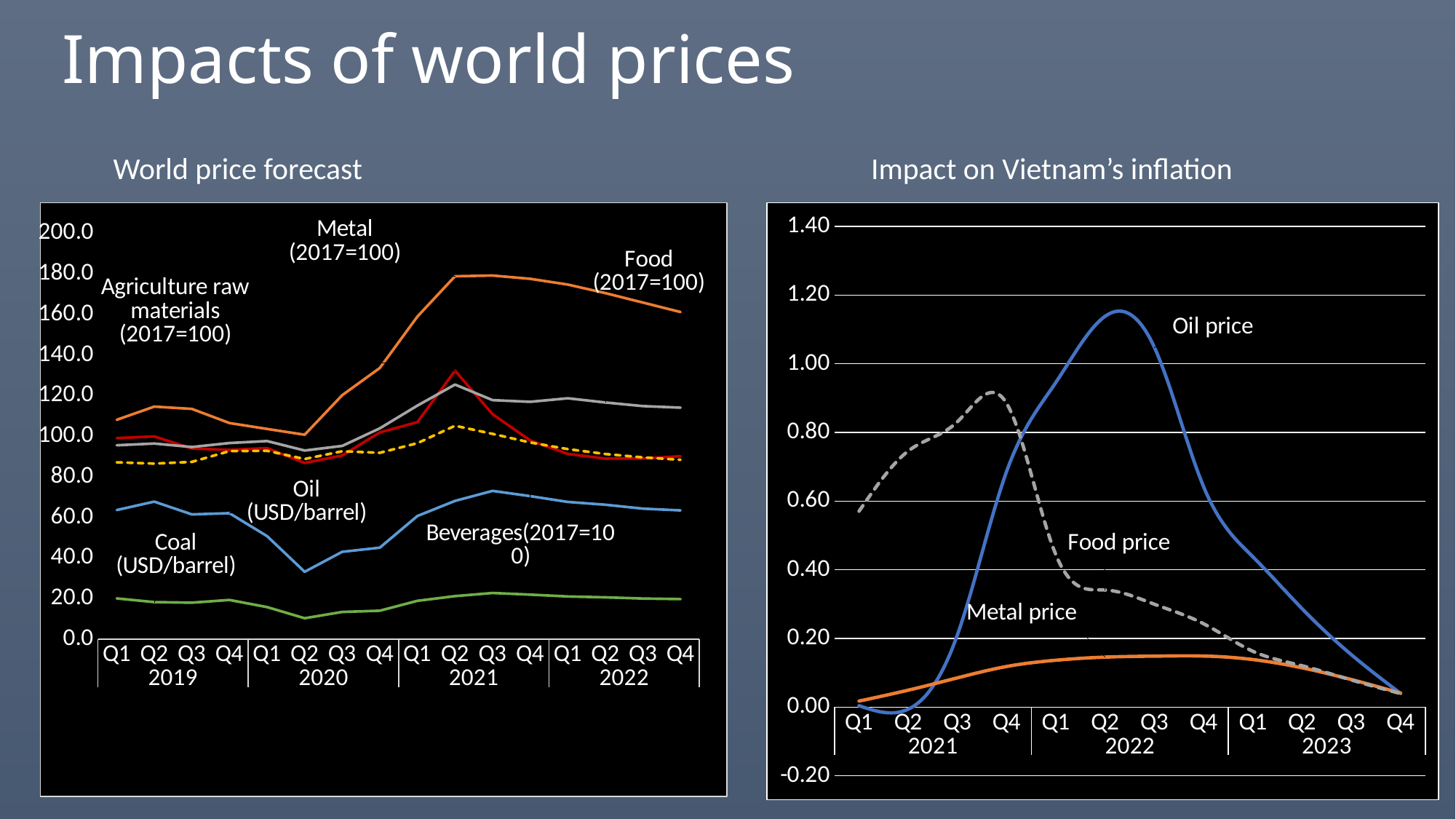
In the 'World price forecast' chart, how many series are plotted? 6 In the 'World price forecast' chart, is the value for Metal in Q2 2021 greater or less than 160.0? greater In the 'World price forecast' chart, does the Metal series rise or fall from Q3 2021 to Q4 2022? fall In the 'World price forecast' chart, how many quarterly points are shown on the x axis? 16 In the 'Impact on Vietnam's inflation' chart, which series reaches the highest peak? Oil price In the 'Impact on Vietnam's inflation' chart, is the value for Oil price in Q2 2022 greater or less than 1.00? greater In the 'Impact on Vietnam's inflation' chart, does the Oil price series rise or fall from Q2 2022 to Q4 2023? fall In the 'World price forecast' chart, which series has the highest value in Q4 2022? Metal (2017=100) In the 'World price forecast' chart, is the value for Oil in Q2 2020 greater or less than 40.0? less In the 'Impact on Vietnam's inflation' chart, how many series are plotted? 3 In the 'World price forecast' chart, which series has the lowest values across the whole period? Coal (USD/barrel) What type of chart is the 'World price forecast' chart? line chart